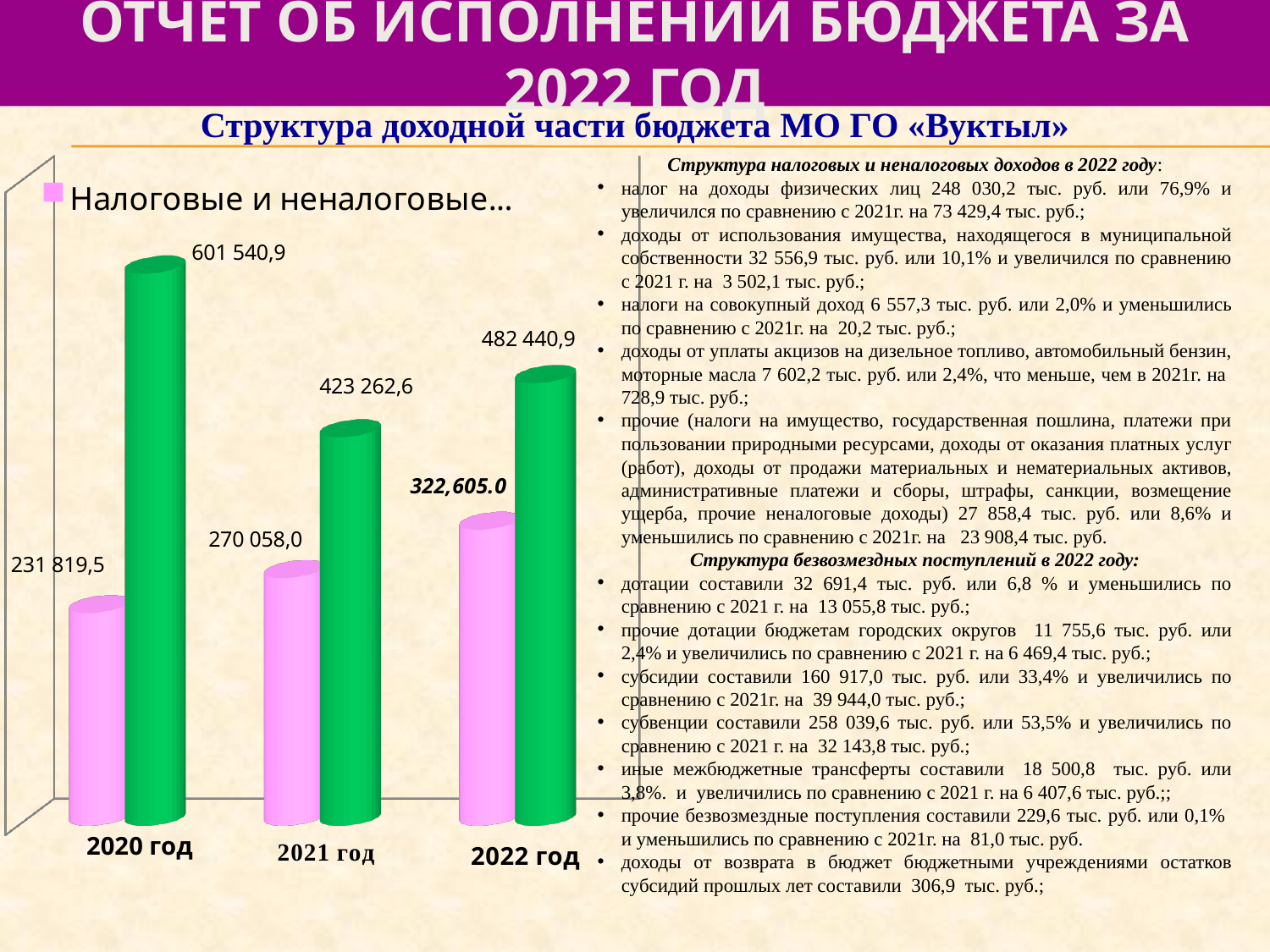
What is the value of the pink bar (Налоговые и неналоговые…) for 2022 год? 322,605.0 Do the values of the pink series (Налоговые и неналоговые…) rise or fall from 2020 год to 2022 год? rise What is the value of the green bar for 2020 год? 601 540,9 What is the difference between the pink bar values for 2021 год and 2020 год? 38 238,5 How many years (categories) are shown on the x axis of the chart? 3 In which year is the green bar the highest? 2020 год What is the value of the pink bar (Налоговые и неналоговые…) for 2020 год? 231 819,5 What type of chart is shown on the slide? bar chart What is the value of the green bar for 2021 год? 423 262,6 In which year is the pink bar (Налоговые и неналоговые…) the lowest? 2020 год What is the difference between the green bar values for 2022 год and 2021 год? 59 178,3 Which year has the larger green bar, 2021 год or 2022 год? 2022 год